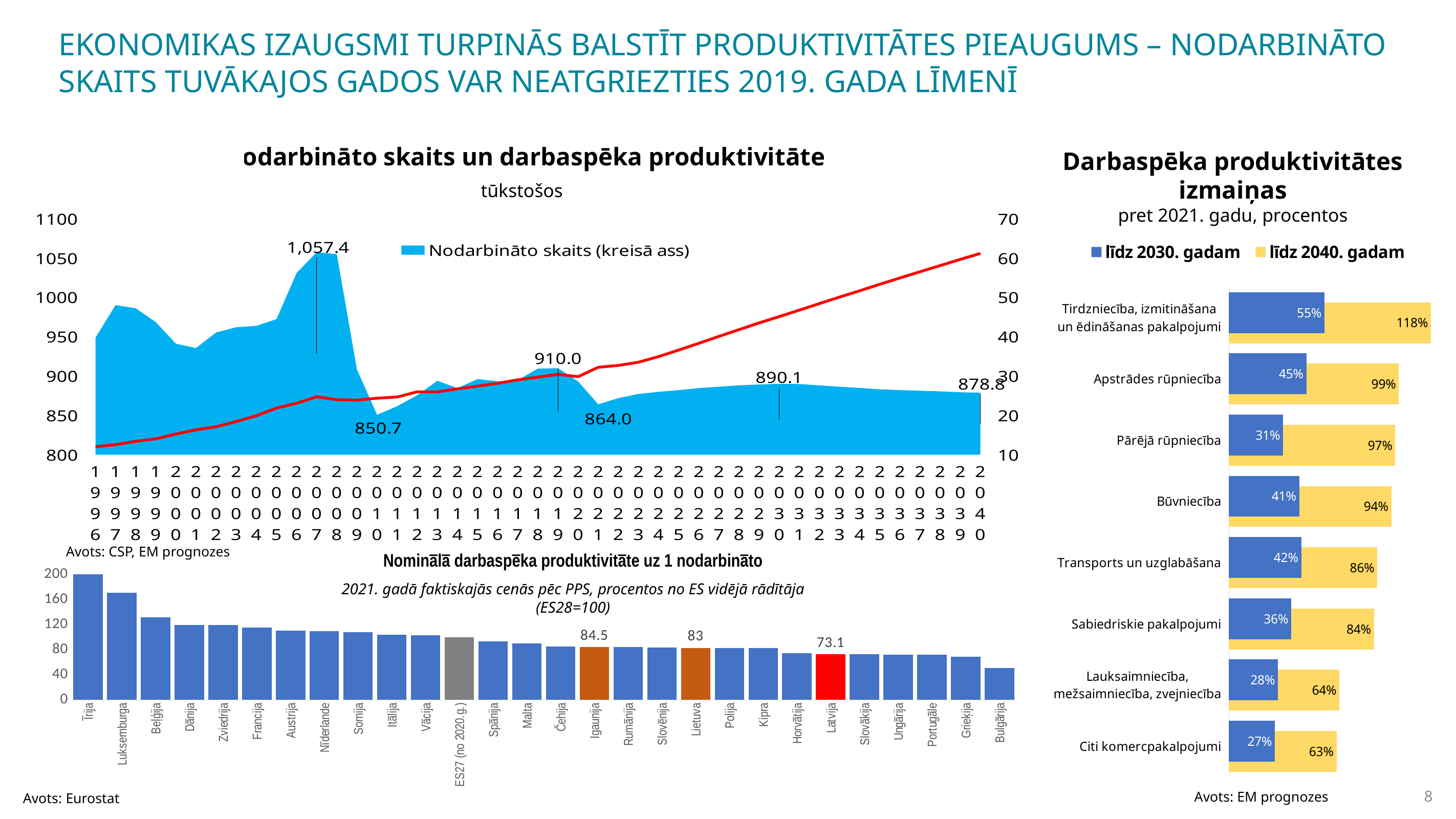
In the chart 'Nominālā darbaspēka produktivitāte uz 1 nodarbināto', is the value for Bulgārija greater or less than 80? less In the chart 'Nominālā darbaspēka produktivitāte uz 1 nodarbināto', which country has the highest value? Īrija In the chart 'Darbaspēka produktivitātes izmaiņas', what is the difference between the 'līdz 2040. gadam' and 'līdz 2030. gadam' values for Transports un uzglabāšana? 44% In the chart 'Darbaspēka produktivitātes izmaiņas', how many categories are shown? 8 In the chart 'Nominālā darbaspēka produktivitāte uz 1 nodarbināto', which is larger, the value for Igaunija or Lietuva? Igaunija In the chart 'Darbaspēka produktivitātes izmaiņas', how many series does the legend list? 2 In the top-left chart 'Nodarbināto skaits un darbaspēka produktivitāte', what is the labelled value of Nodarbināto skaits for 2007? 1,057.4 In the chart 'Darbaspēka produktivitātes izmaiņas', which category has the lowest value for 'līdz 2030. gadam'? Citi komercpakalpojumi In the chart 'Darbaspēka produktivitātes izmaiņas', what is the value for Apstrādes rūpniecība for 'līdz 2030. gadam'? 45% In the chart 'Nominālā darbaspēka produktivitāte uz 1 nodarbināto', what is the value for Latvija? 73.1 In the chart 'Darbaspēka produktivitātes izmaiņas', which category has the highest value for 'līdz 2040. gadam'? Tirdzniecība, izmitināšana un ēdināšanas pakalpojumi In the chart 'Darbaspēka produktivitātes izmaiņas', what is the value for Būvniecība for 'līdz 2040. gadam'? 94%